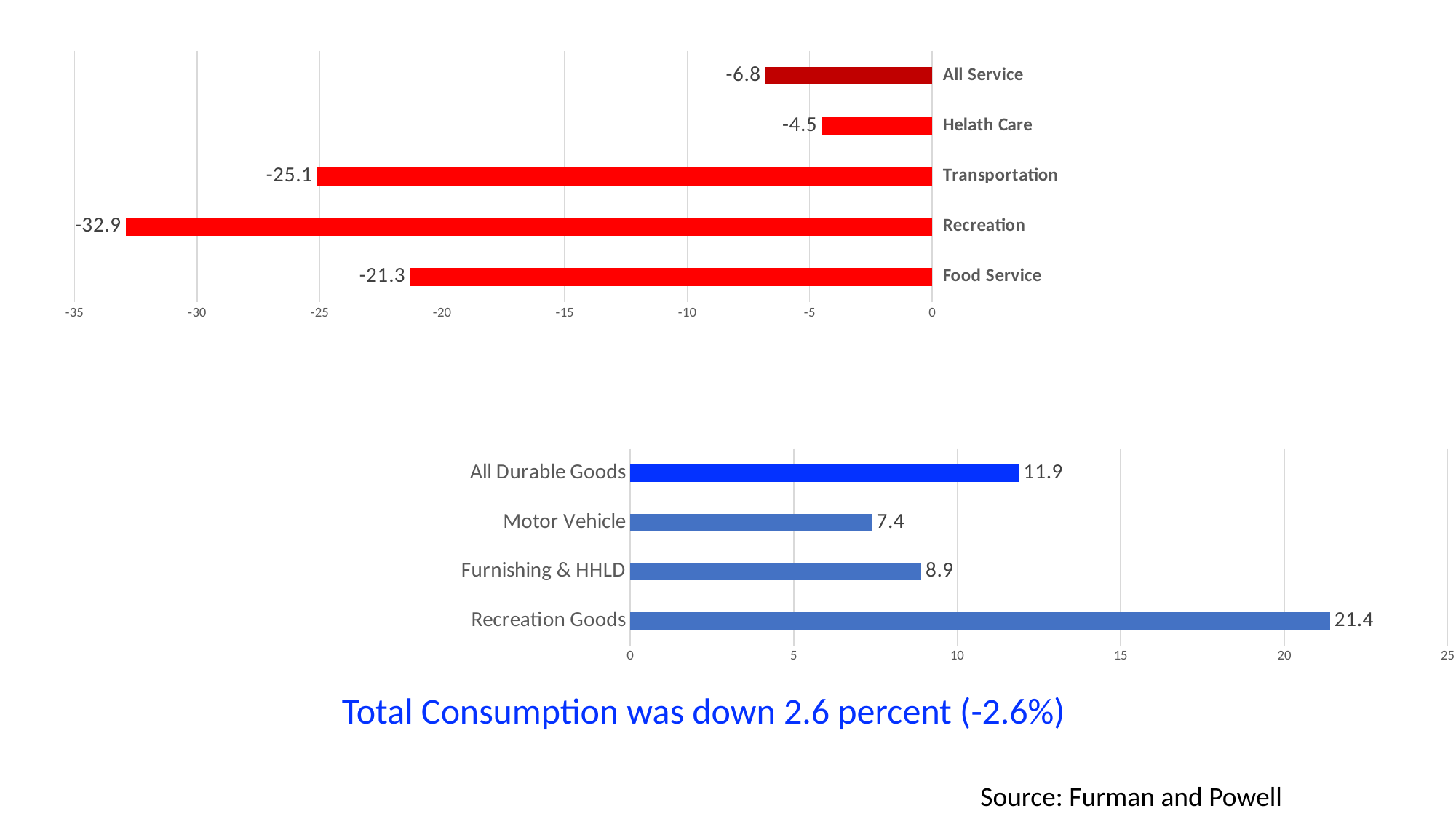
In the bottom chart, which is larger, the value for Motor Vehicle or the value for Furnishing & HHLD? Furnishing & HHLD In the top chart, what is the value for Recreation? -32.9 In the top chart, what is the value for Helath Care? -4.5 In the top chart, what is the difference between the values for Transportation and Food Service? 3.8 In the bottom chart, which category has the highest value? Recreation Goods What kind of chart is the bottom chart? Bar chart In the bottom chart, which category has the lowest value? Motor Vehicle In the bottom chart, what is the difference between the values for Recreation Goods and All Durable Goods? 9.5 In the top chart, which category has the highest value? Helath Care In the bottom chart, what is the value for Furnishing & HHLD? 8.9 In the top chart, how many categories are shown? 5 In the top chart, which category has the lowest value? Recreation